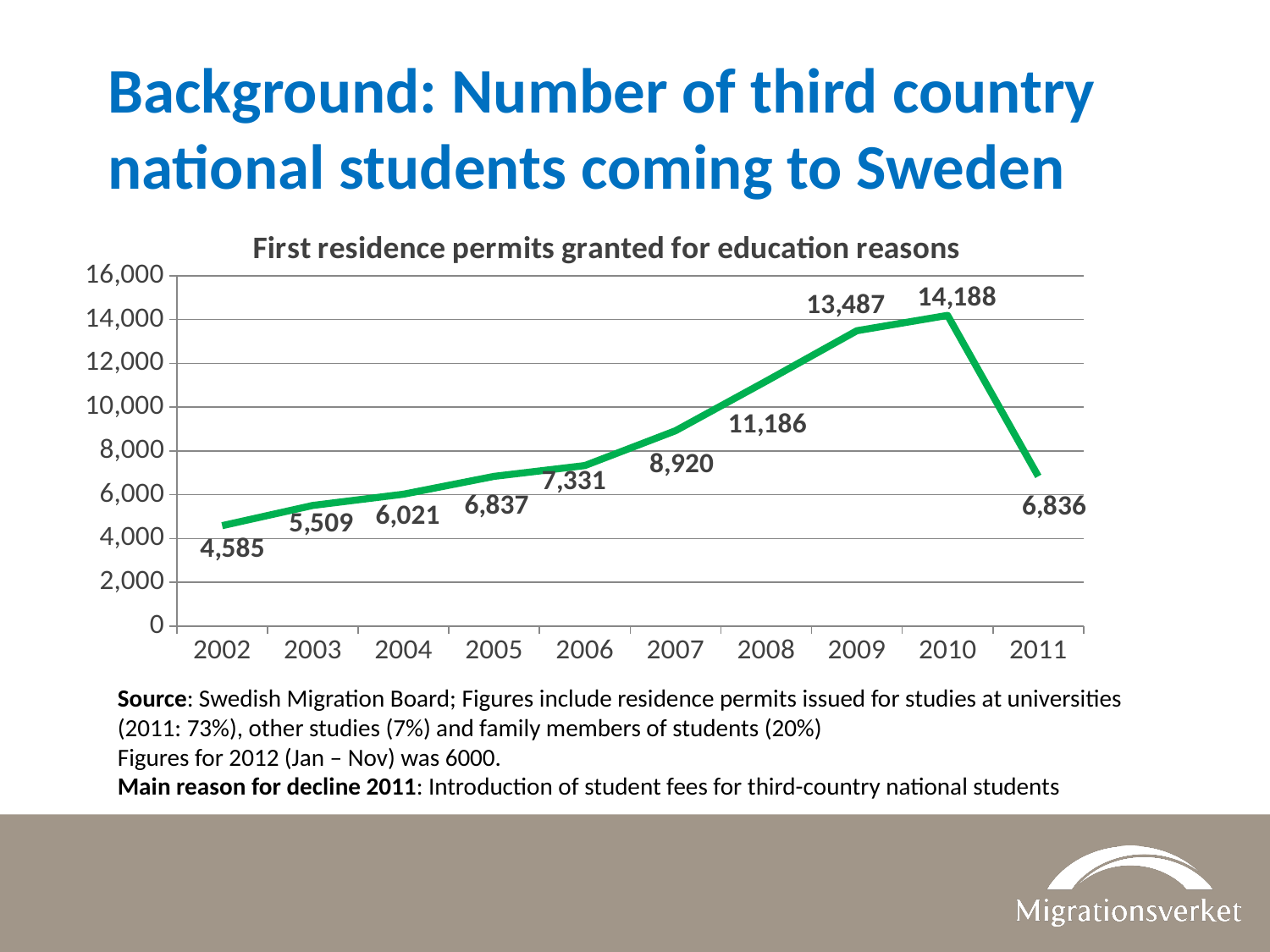
What kind of chart is shown? line chart What is the difference between the values for 2010 and 2011? 7,352 Which is larger, the value for 2009 or the value for 2008? 2009 What is the value for 2010? 14,188 Do the values rise or fall from 2002 to 2010? rise What is the title of the chart? First residence permits granted for education reasons What is the value for 2002? 4,585 Is the value for 2007 greater or less than 10,000? less Which year has the lowest value? 2002 How many years are plotted on the chart? 10 What is the value for 2011? 6,836 Which year has the highest value? 2010